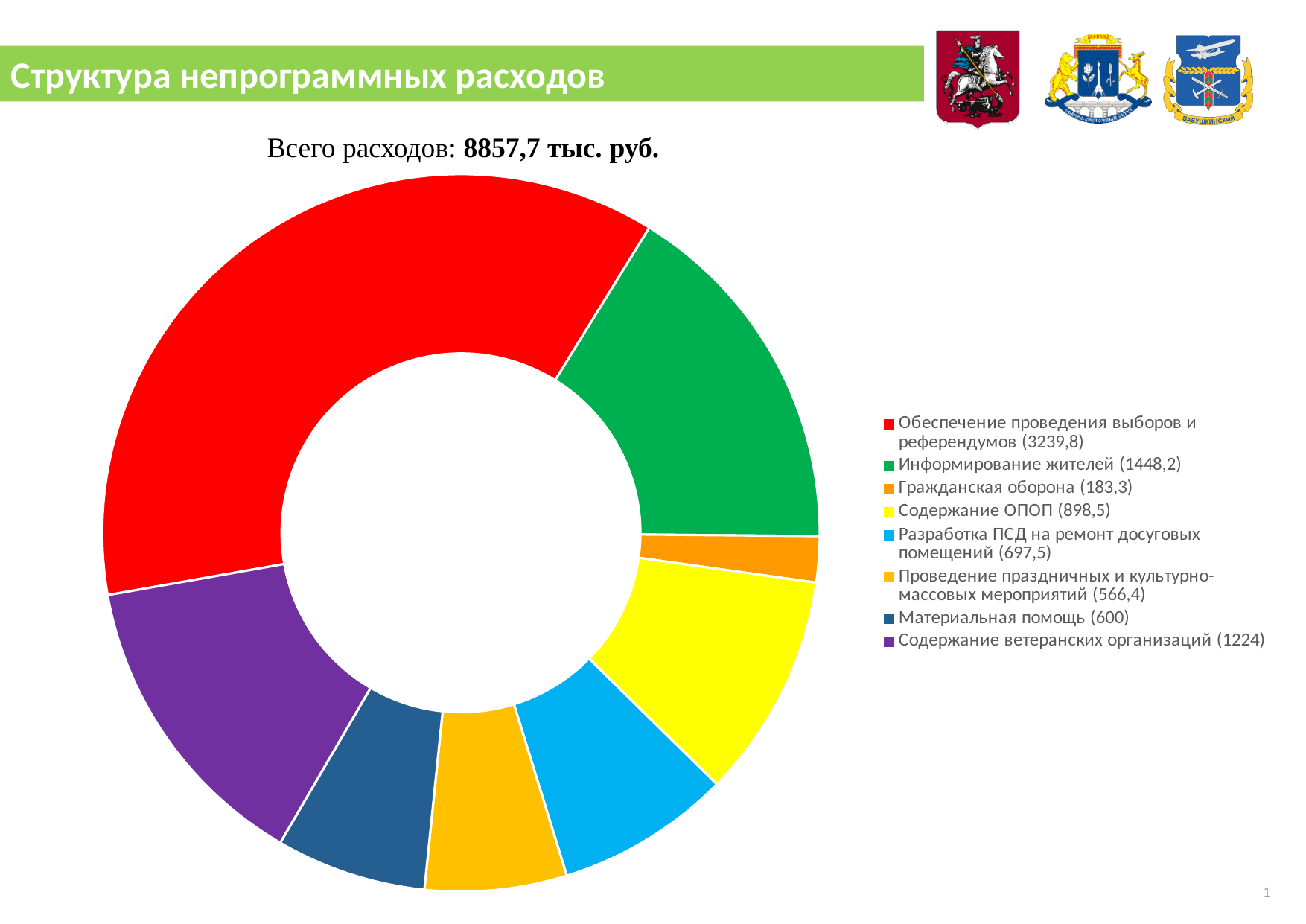
What total expenditure is stated above the chart? 8857,7 тыс. руб. What is the value for Содержание ветеранских организаций? 1224 Which category has the largest value? Обеспечение проведения выборов и референдумов What is the value for Информирование жителей? 1448,2 What kind of chart is shown on the slide? Doughnut (pie) chart How many categories does the chart show? 8 What is the difference between Обеспечение проведения выборов и референдумов and Информирование жителей? 1791,6 What is the difference between Содержание ветеранских организаций and Материальная помощь? 624 Which is larger: Материальная помощь or Проведение праздничных и культурно-массовых мероприятий? Материальная помощь What is the value for Гражданская оборона? 183,3 What is the value for Обеспечение проведения выборов и референдумов? 3239,8 Which category has the smallest value? Гражданская оборона